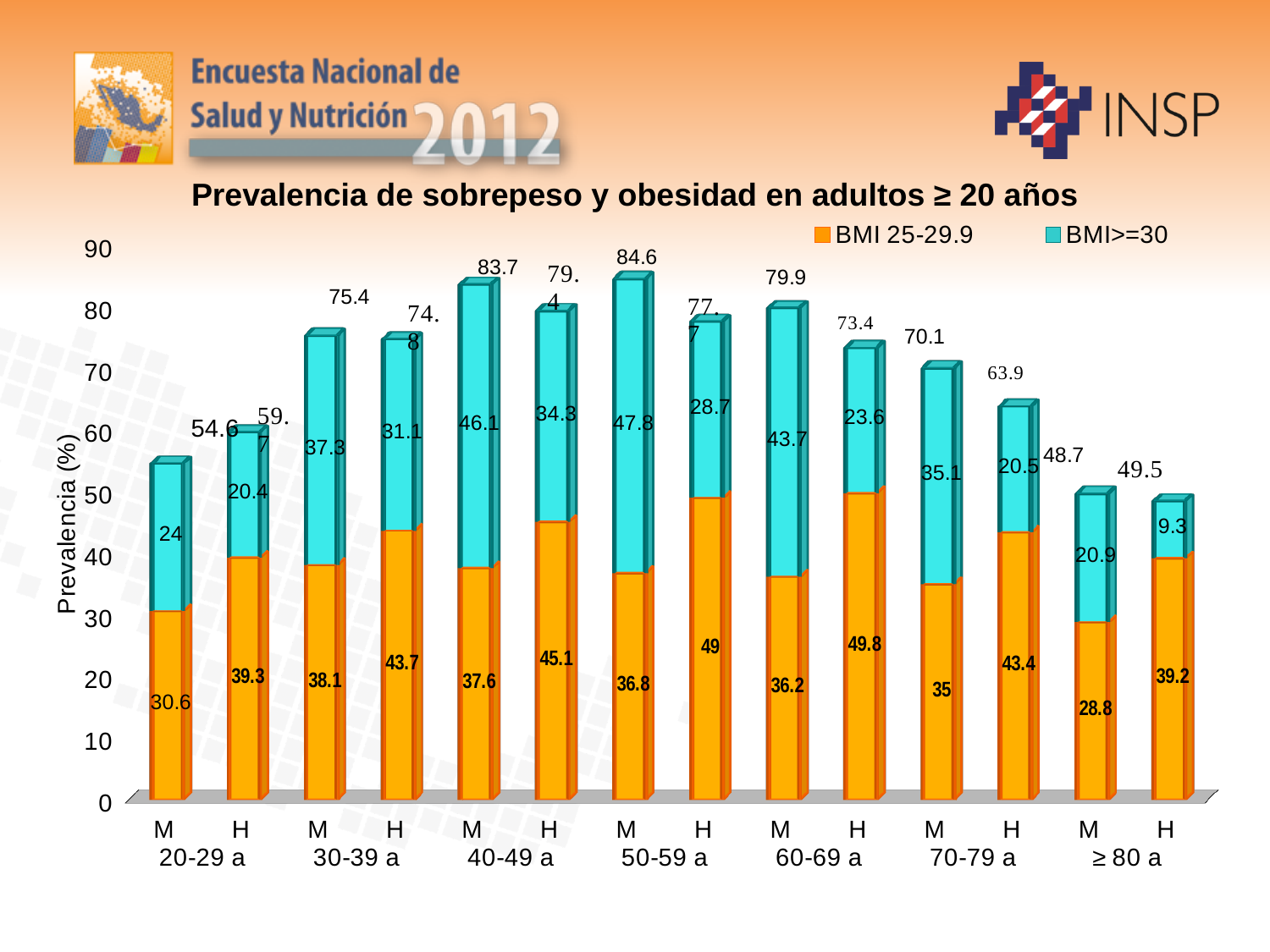
In the 60-69 a group, which has the larger BMI 25-29.9 value, M or H? H What kind of chart is shown on the slide? Stacked bar chart How many series does the legend list? 2 What are the two legend entries of the chart? BMI 25-29.9 and BMI>=30 Which bar has the highest BMI 25-29.9 value? H 60-69 a What is the total of the stacked bar for M in the 40-49 a group? 83.7 Which bar has the lowest BMI>=30 value? H ≥ 80 a Which bar has the highest total prevalence? M 50-59 a How many bars are plotted in the chart? 14 What is the difference between the BMI>=30 values for M and H in the 50-59 a group? 19.1 What is the BMI>=30 value for H in the 20-29 a group? 20.4 What is the BMI 25-29.9 value for M in the 50-59 a group? 36.8